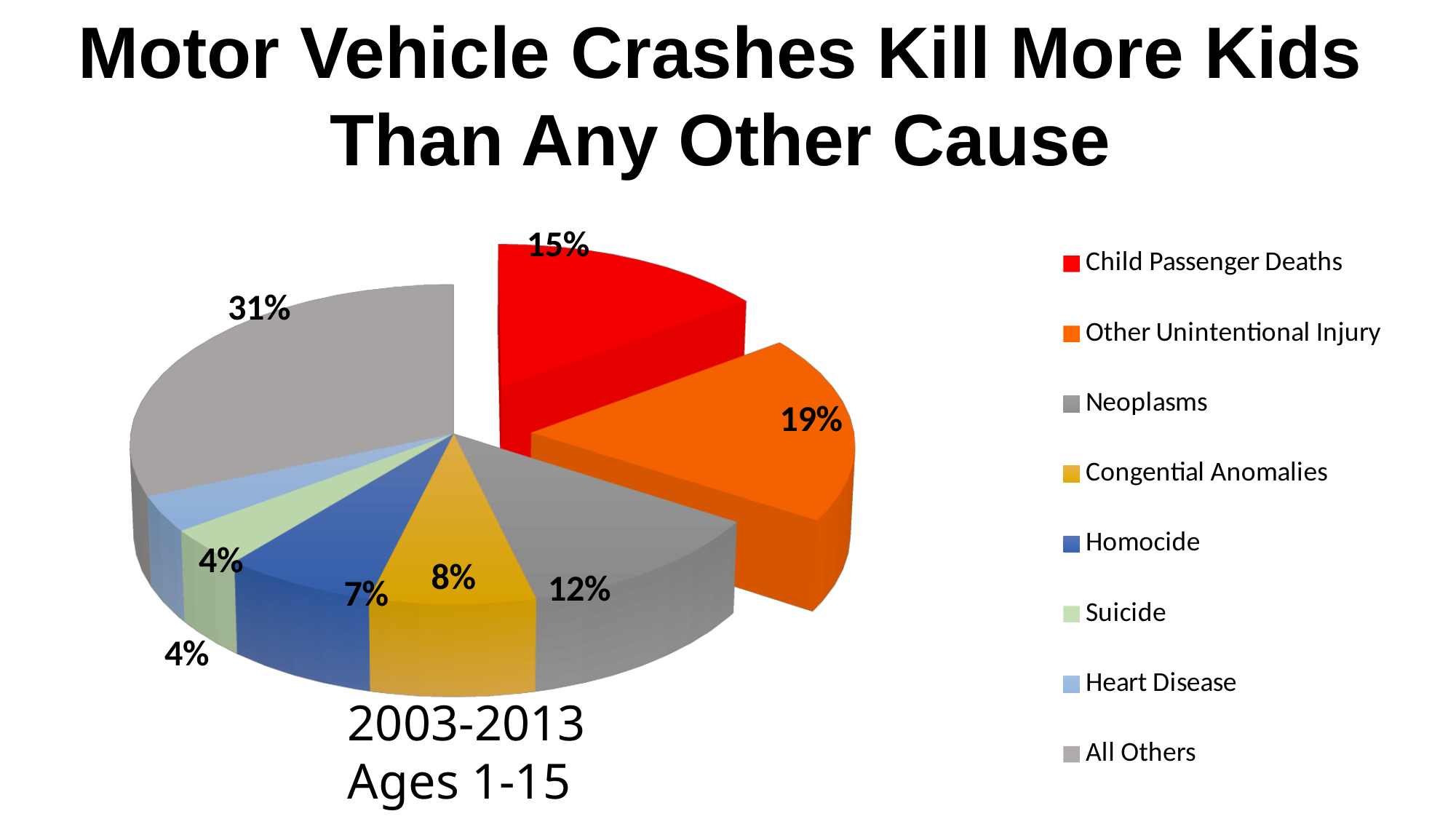
What percentage of the pie is Congential Anomalies? 8% What colour represents Child Passenger Deaths in the legend? Red Which is larger, the share for Neoplasms or the share for Congential Anomalies? Neoplasms What is the difference in percentage points between Other Unintentional Injury and Child Passenger Deaths? 4 What percentage of the pie is Homocide? 7% What kind of chart is shown on the slide? Pie chart What percentage of the pie is Other Unintentional Injury? 19% How many categories does the pie chart have? 8 Which category has the largest share of the pie? All Others What percentage of the pie is Neoplasms? 12% What is the share of the pie for All Others? 31% What percentage of the pie is Child Passenger Deaths? 15%